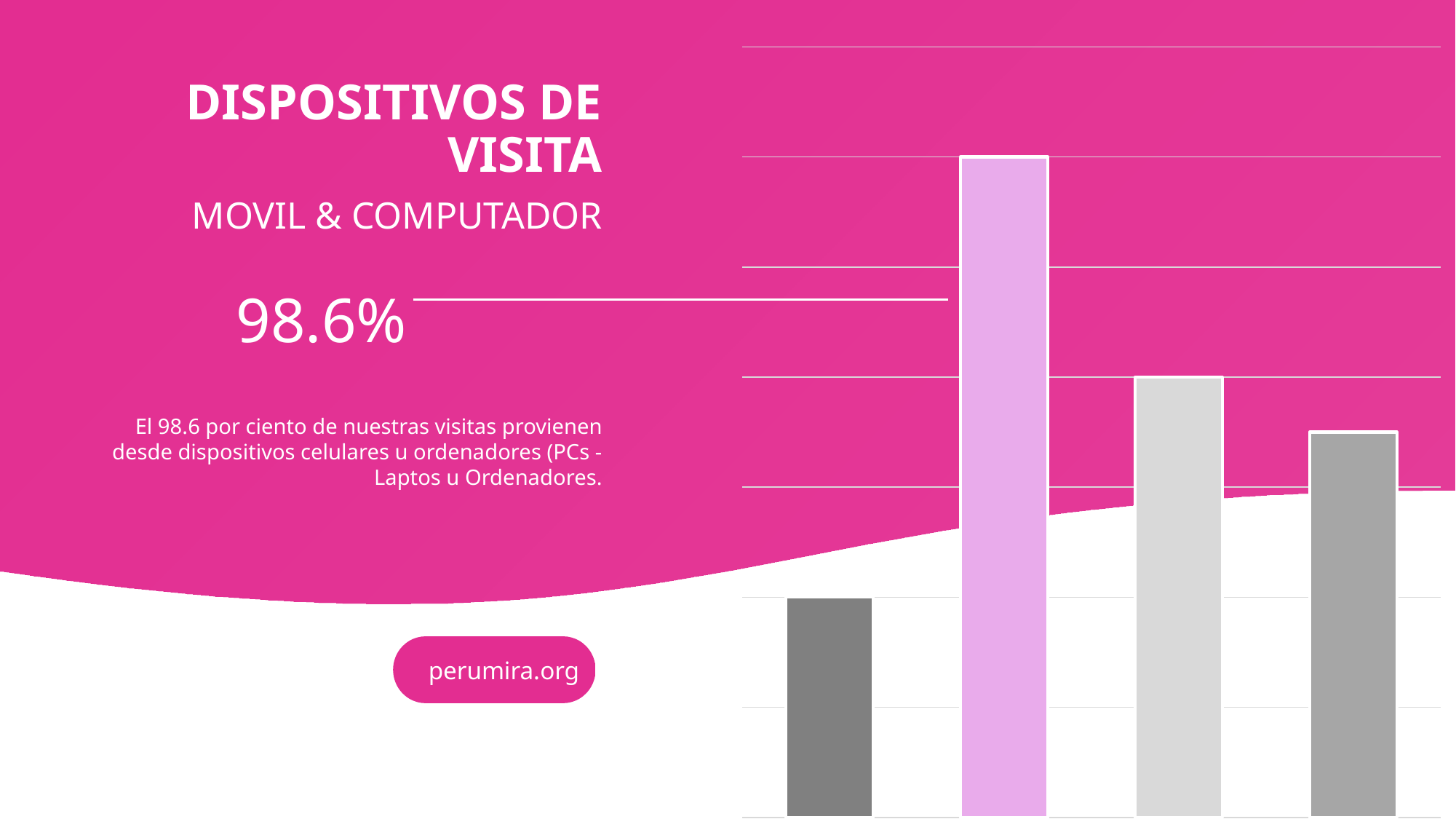
Does the chart on the slide show a legend? No Which is taller in the chart, the third bar or the fourth bar from the left? The third bar Which bar in the chart is the shortest, counting from the left? The first bar Which bar in the chart is the tallest, counting from the left? The second bar What colour is the tallest bar in the chart? Light pink Which is taller in the chart, the second bar or the third bar from the left? The second bar Which is taller in the chart, the first bar or the fourth bar from the left? The fourth bar How many bars does the chart on the slide have? 4 What kind of chart is shown on the right side of the slide? Bar chart